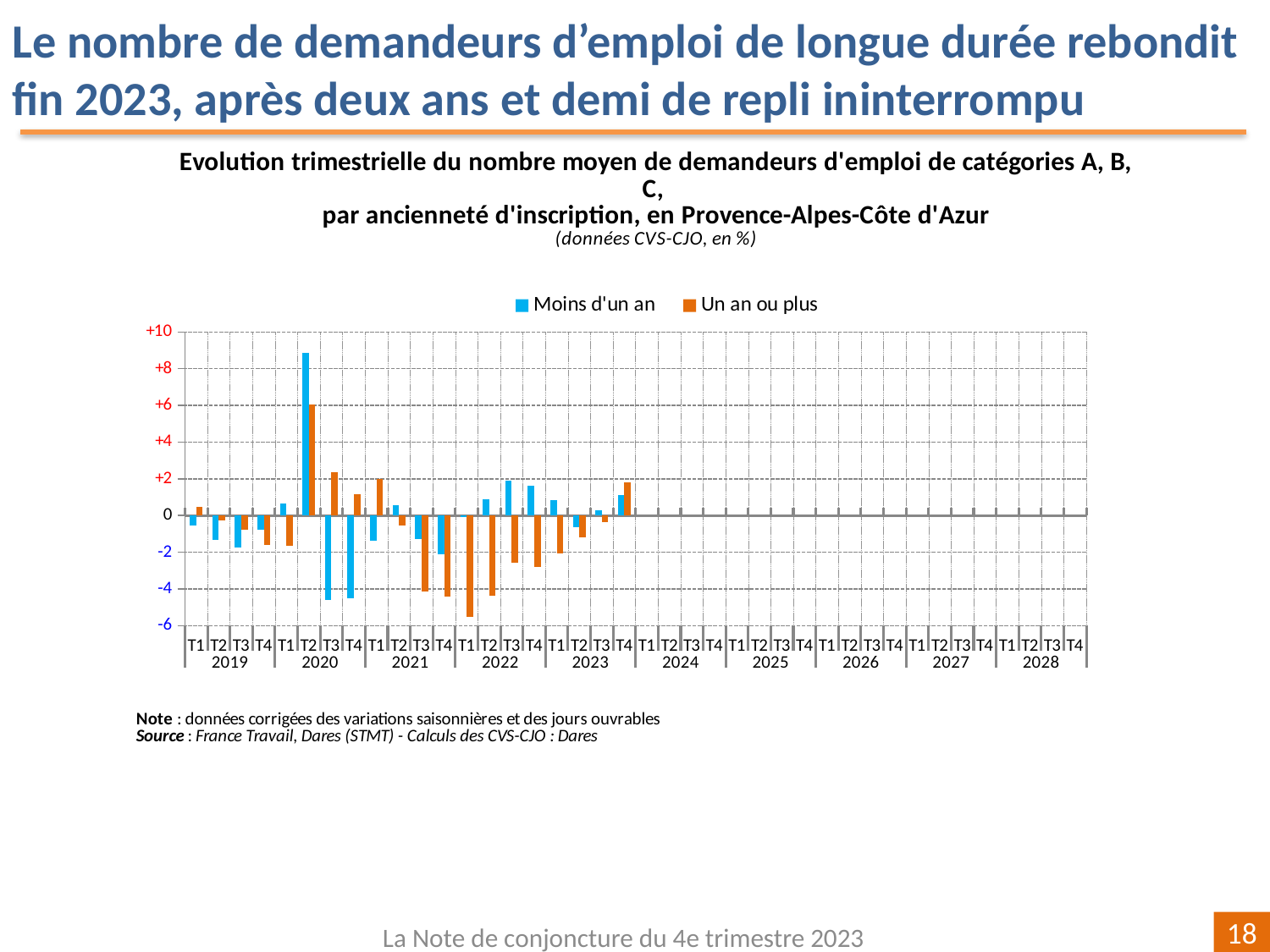
In which quarter does the 'Moins d'un an' series reach its highest value? T2 2020 In T2 2020, which series has the larger value, 'Moins d'un an' or 'Un an ou plus'? Moins d'un an What kind of chart is shown on the slide? bar chart Is the value for 'Un an ou plus' in T3 2020 greater or less than +2? greater Is the value for 'Moins d'un an' in T2 2020 greater or less than +8? greater How many years are labelled along the x axis? 10 What are the two series named in the legend? Moins d'un an; Un an ou plus How many series does the legend list? 2 Is the value for 'Un an ou plus' in T1 2022 greater or less than -4? less In which quarter does the 'Un an ou plus' series reach its lowest value? T1 2022 Which colour represents the series 'Un an ou plus'? orange